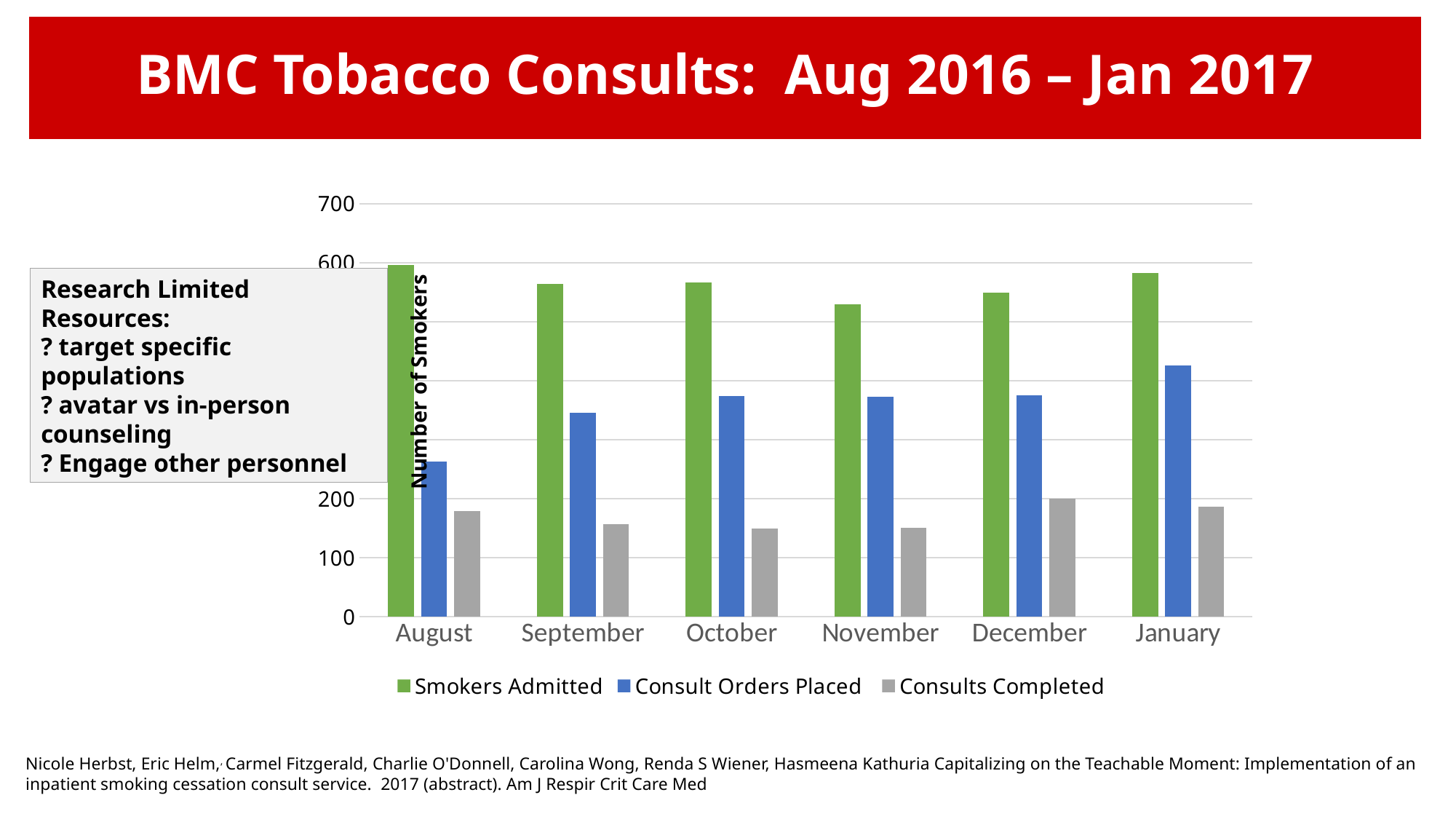
Which month has the lowest value for Smokers Admitted? November Is the value for Consult Orders Placed in August greater or less than 200? greater Which month has the highest value for Consult Orders Placed? January What is the label on the chart's vertical axis? Number of Smokers Which month has the lowest value for Consult Orders Placed? August Is the value for Consults Completed in August greater or less than 200? less What kind of chart is shown on the slide? bar chart Does the value for Consult Orders Placed generally rise or fall from August to January? rise How many months are shown on the x axis of the chart? 6 In October, which is larger: Smokers Admitted or Consult Orders Placed? Smokers Admitted How many series does the chart's legend list? 3 Is the value for Smokers Admitted in November greater or less than 600? less